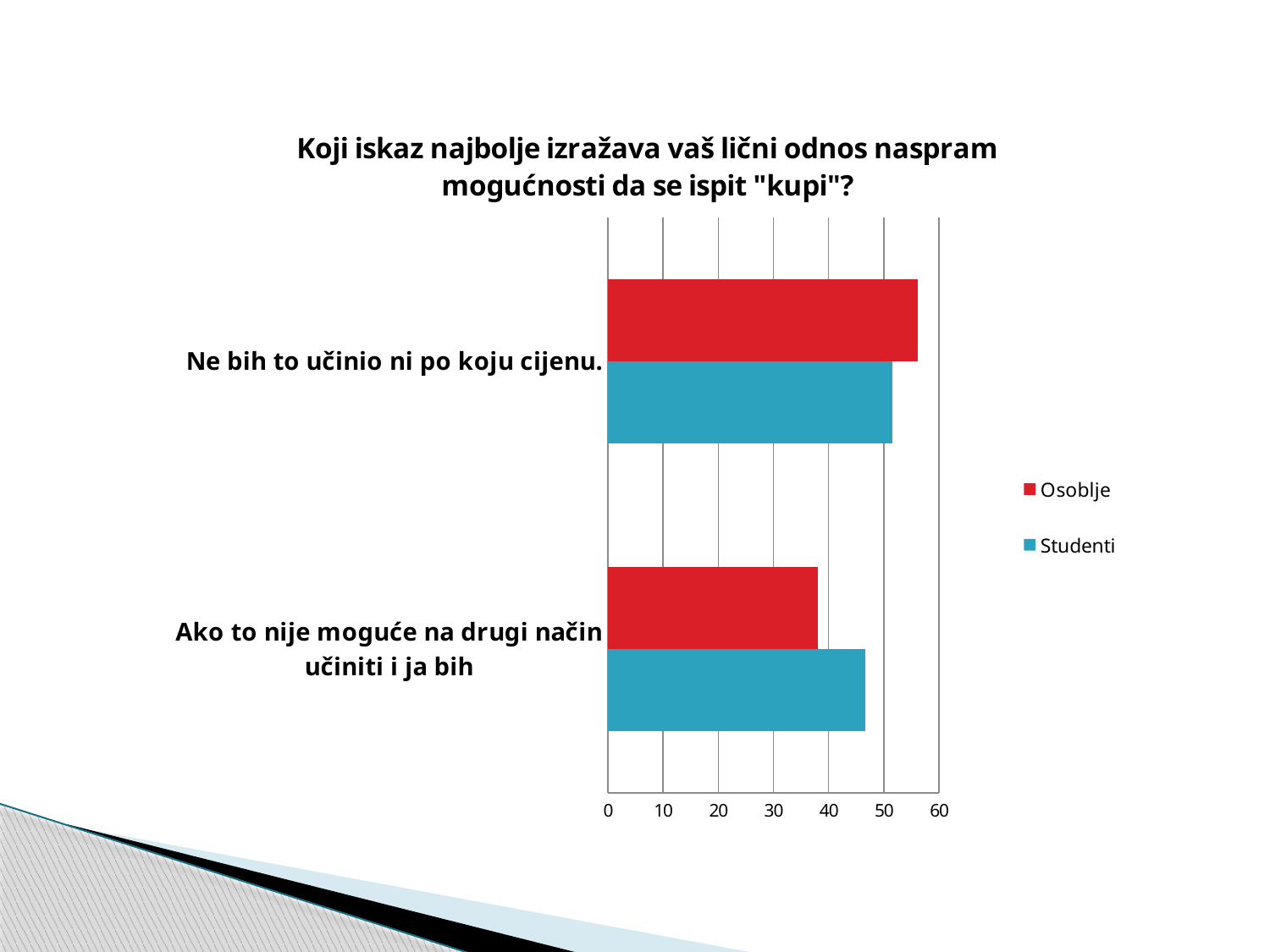
Is the Osoblje value for "Ne bih to učinio ni po koju cijenu." greater or less than 50? greater What is the title of the chart? Koji iskaz najbolje izražava vaš lični odnos naspram mogućnosti da se ispit "kupi"? How many categories are shown on the chart? 2 Is the Studenti value for "Ako to nije moguće na drugi način učiniti i ja bih" greater or less than 40? greater Which series is shown in red? Osoblje Is the Studenti value for "Ako to nije moguće na drugi način učiniti i ja bih" greater or less than 50? less For "Ne bih to učinio ni po koju cijenu.", which series has the larger value, Osoblje or Studenti? Osoblje How many series does the legend list? 2 What kind of chart is shown on the slide? bar chart Which category has the higher Osoblje value? Ne bih to učinio ni po koju cijenu. For "Ako to nije moguće na drugi način učiniti i ja bih", which series has the larger value, Osoblje or Studenti? Studenti